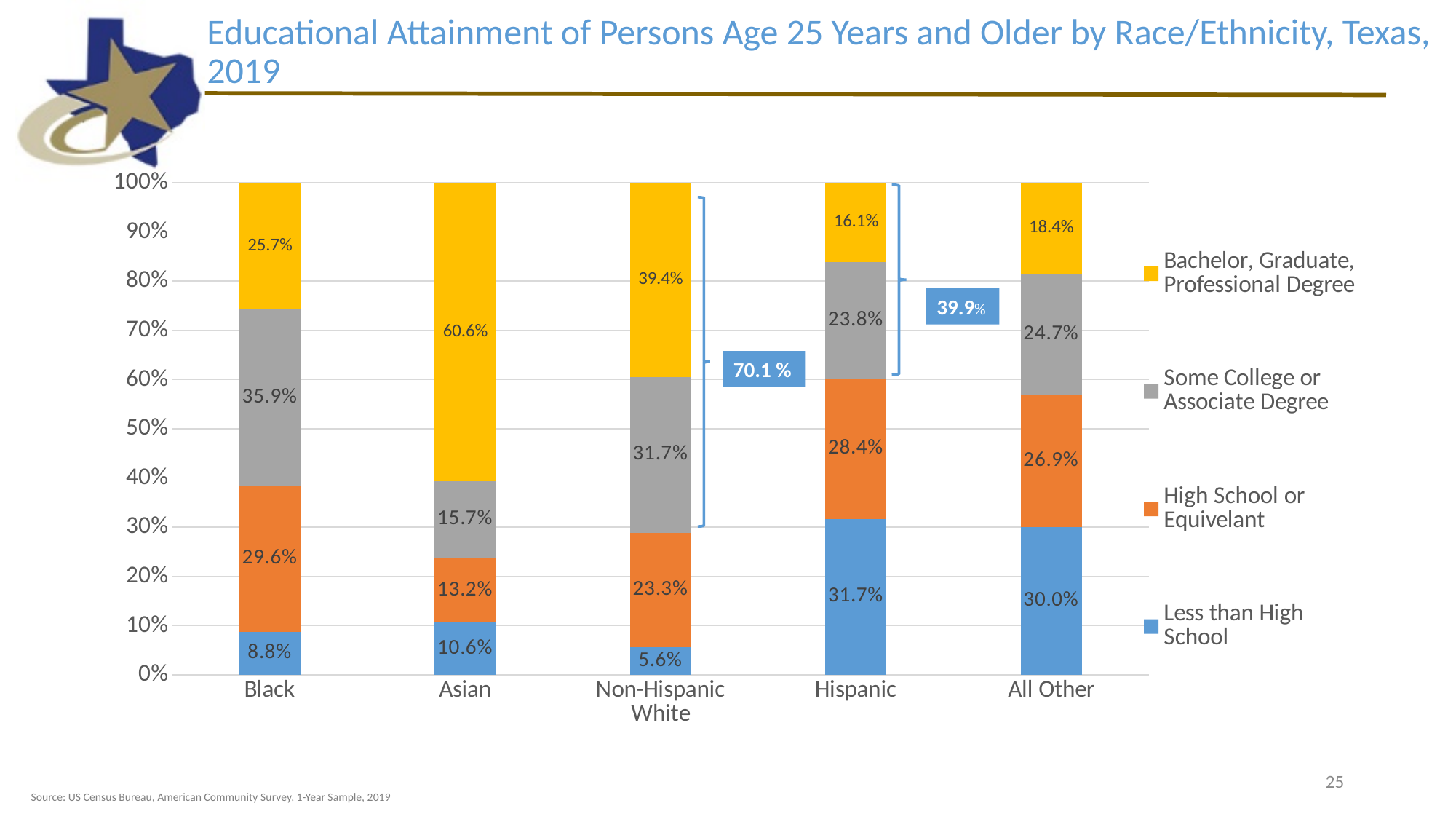
What is the High School or Equivelant value for the Asian group? 13.2% Which race/ethnicity group has the highest share with a Bachelor, Graduate, or Professional Degree? Asian What percentage of Black persons age 25 and older have a Bachelor, Graduate, or Professional Degree? 25.7% What is the difference between the Bachelor, Graduate, Professional Degree shares for Asian and Hispanic persons? 44.5% How many series does the legend list? 4 How many race/ethnicity categories are shown on the x axis? 5 What is the Less than High School share for Hispanic persons? 31.7% Which is larger: the Some College or Associate Degree share for Black persons or for Non-Hispanic White persons? Black Which legend entry is shown in yellow? Bachelor, Graduate, Professional Degree What kind of chart is shown on the slide? Stacked bar chart What is the combined share of Some College or Associate Degree and Bachelor, Graduate, Professional Degree for Hispanic persons? 39.9% Which group has the lowest Less than High School share? Non-Hispanic White